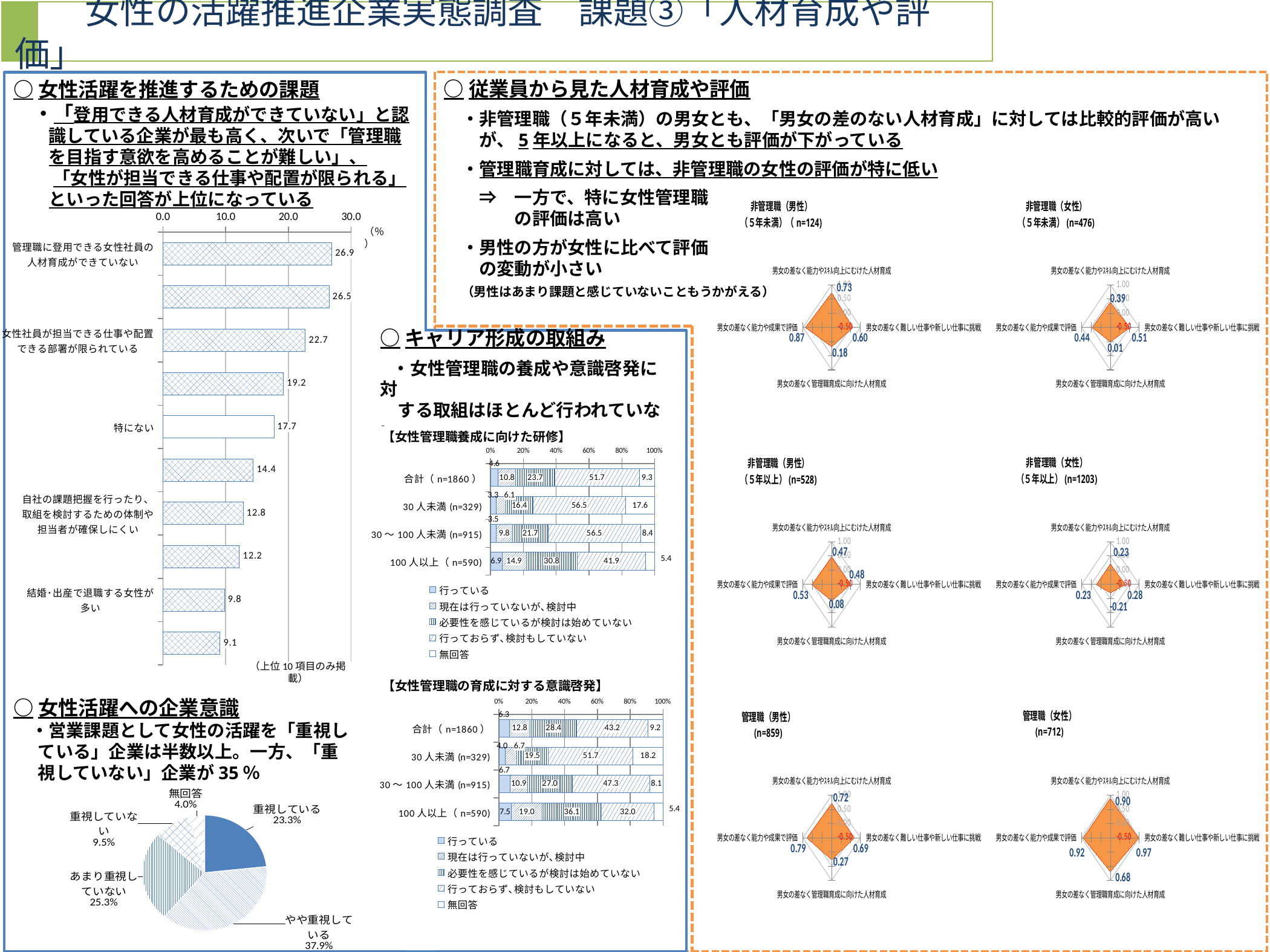
In the radar chart 「非管理職（女性）（5年以上）(n=1203)」, what is the value for 「男女の差なく管理職育成に向けた人材育成」? -0.21 In the bar chart 「女性活躍を推進するための課題」, what is the value for 「管理職に登用できる女性社員の人材育成ができていない」? 26.9 In the pie chart 「女性活躍への企業意識」, which slice is the smallest? 無回答 In the stacked bar chart 「女性管理職の育成に対する意識啓発」, what is the value of 「現在は行っていないが、検討中」 for 「合計 (n=1860)」? 12.8 In the stacked bar chart 「女性管理職養成に向けた研修」, what is the value of 「行っておらず、検討もしていない」 for 「100人以上 (n=590)」? 41.9 In the radar chart 「管理職（女性）(n=712)」, what is the value for 「男女の差なく難しい仕事や新しい仕事に挑戦」? 0.97 What kind of chart is 「女性活躍への企業意識」? pie chart How many series does the legend of the stacked bar chart 「女性管理職の育成に対する意識啓発」 list? 5 In the bar chart 「女性活躍を推進するための課題」, what is the value for 「特にない」? 17.7 In the pie chart 「女性活躍への企業意識」, what share does 「やや重視している」 have? 37.9% In the pie chart 「女性活躍への企業意識」, which is larger: 「重視している」 or 「あまり重視していない」? あまり重視していない In the bar chart 「女性活躍を推進するための課題」, what is the difference between 「女性社員が担当できる仕事や配置できる部署が限られている」 and 「結婚・出産で退職する女性が多い」? 12.9